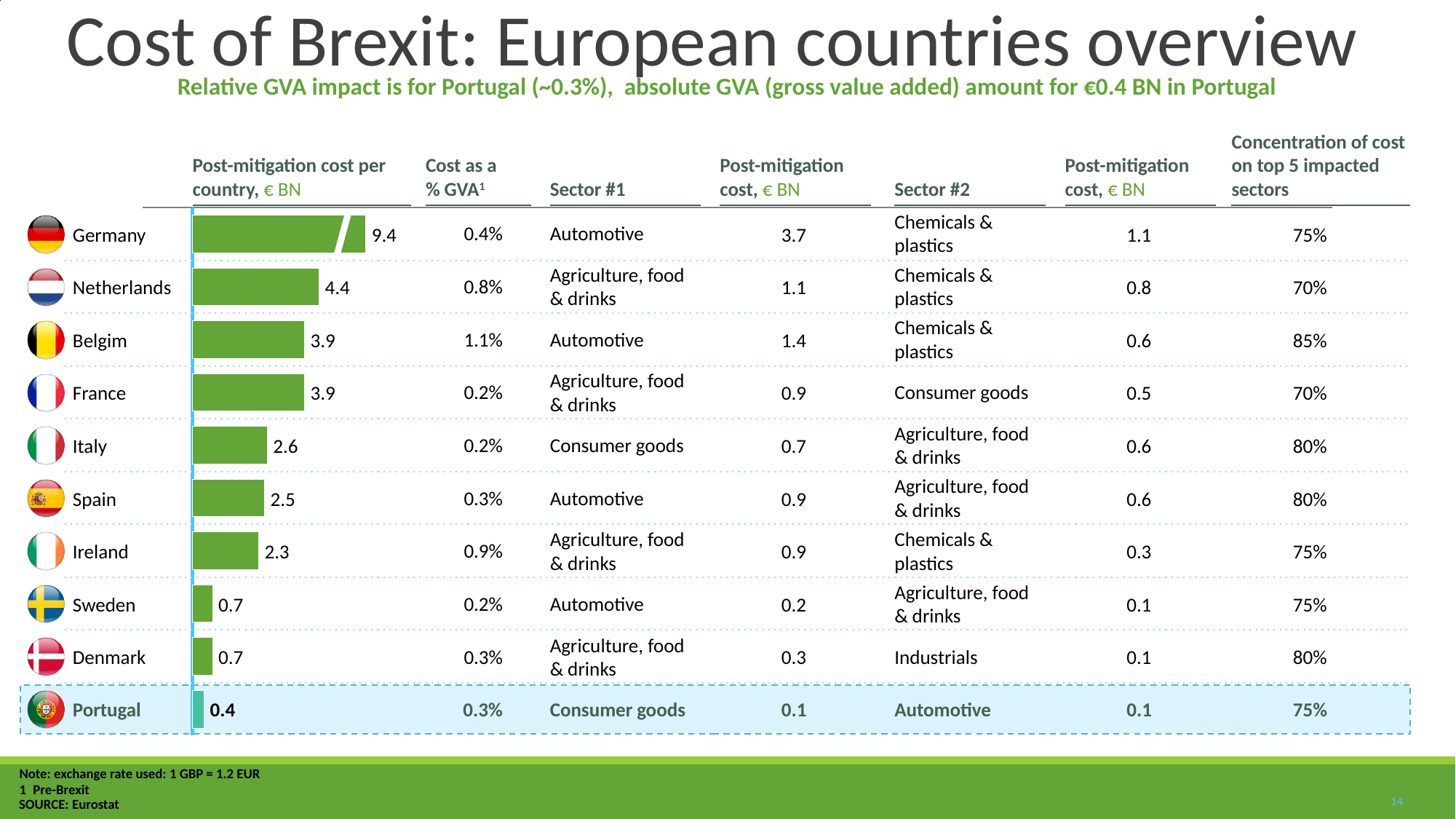
What is the difference in post-mitigation cost per country between Germany and Netherlands, in € BN? 5.0 Which country's bar in the post-mitigation cost per country chart is shown in a different colour from the others? Portugal What is the difference in post-mitigation cost per country between Italy and Spain, in € BN? 0.1 What is the post-mitigation cost per country in € BN for Netherlands? 4.4 Which has a larger post-mitigation cost per country, Belgium or Italy? Belgium Which has a larger post-mitigation cost per country, Sweden or Portugal? Sweden What is the post-mitigation cost per country in € BN for Germany? 9.4 How many countries are shown in the post-mitigation cost per country bar chart? 10 What type of chart shows the post-mitigation cost per country? Bar chart What is the post-mitigation cost per country in € BN for Ireland? 2.3 Which country has the highest post-mitigation cost per country? Germany Which country has the lowest post-mitigation cost per country? Portugal